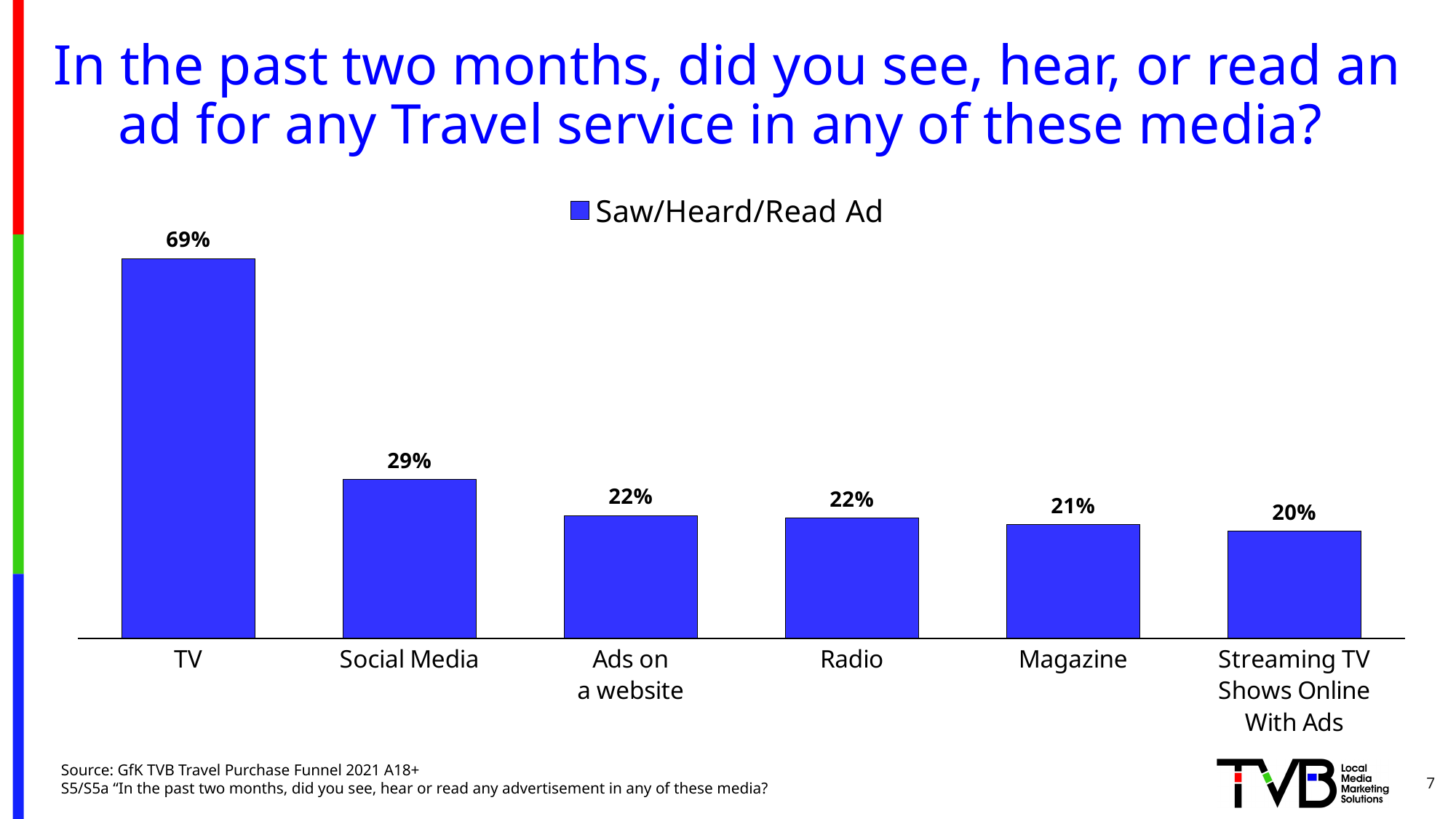
What percentage saw, heard, or read a travel service ad on TV? 69% How many series does the legend list? 1 Which medium has the lowest percentage? Streaming TV Shows Online With Ads What is the value for Magazine? 21% What is the value for Social Media? 29% What is the difference between the Radio value and the Streaming TV Shows Online With Ads value? 2% What is the difference between the TV value and the Social Media value? 40% What kind of chart is shown on the slide? Bar chart How many media categories are shown on the chart? 6 Which is larger, the value for Social Media or the value for Radio? Social Media What is the value for Streaming TV Shows Online With Ads? 20% Which medium has the highest percentage? TV